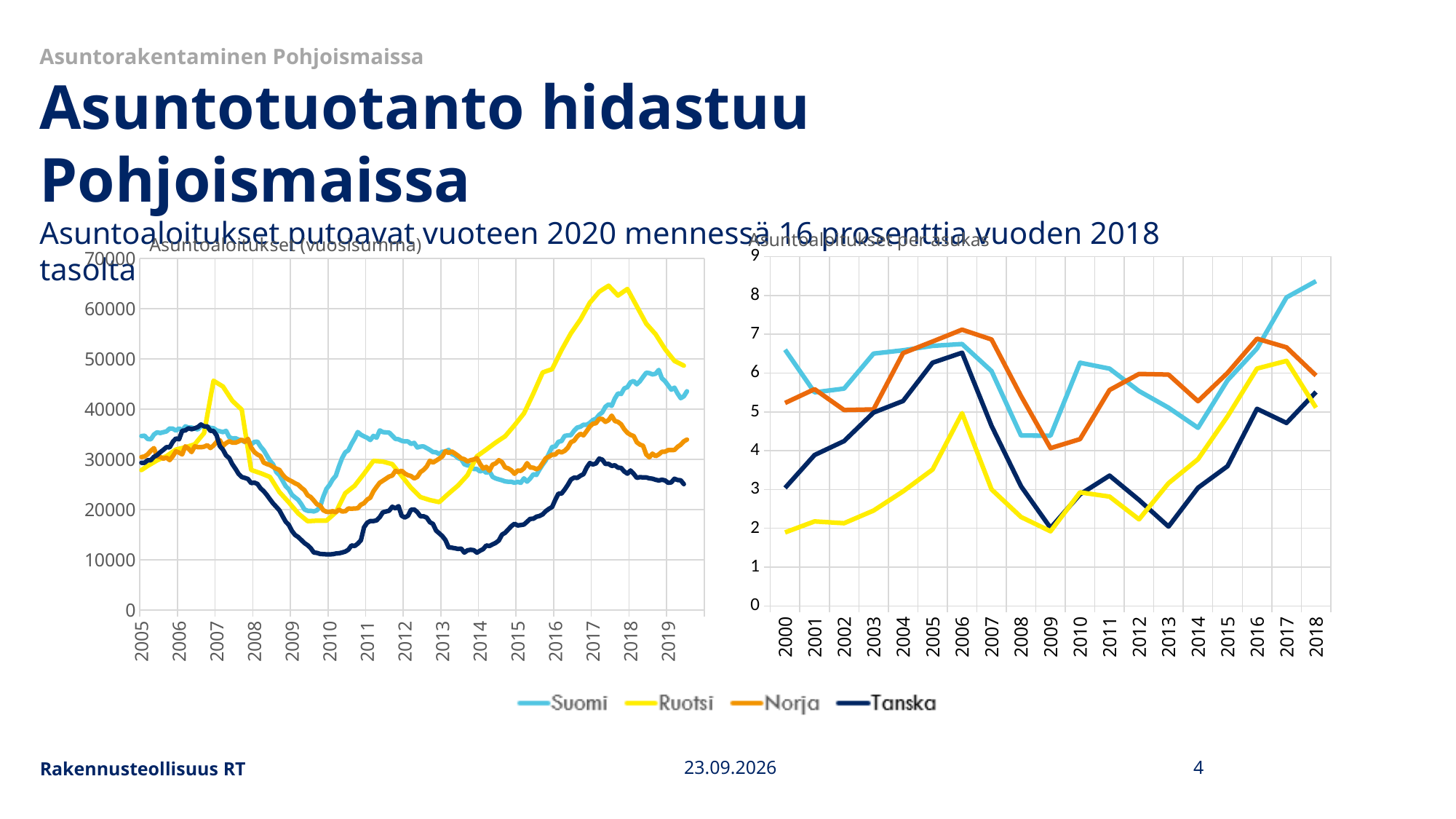
In the right chart 'Asuntoaloitukset per asukas', which is larger in 2009, Suomi or Tanska? Suomi In the left chart 'Asuntoaloitukset (vuosisumma)', which series has the highest value in 2017? Ruotsi In the right chart 'Asuntoaloitukset per asukas', which series has the lowest value in 2000? Ruotsi In the left chart 'Asuntoaloitukset (vuosisumma)', is the peak value for Ruotsi around 2017 greater or less than 60000? greater In the right chart 'Asuntoaloitukset per asukas', is the value for Suomi in 2018 greater or less than 8? greater What kind of chart is the left chart titled 'Asuntoaloitukset (vuosisumma)'? line chart In the right chart 'Asuntoaloitukset per asukas', which series has the highest value in 2018? Suomi In the right chart 'Asuntoaloitukset per asukas', does the Suomi line rise or fall from 2014 to 2018? rise In the left chart 'Asuntoaloitukset (vuosisumma)', is the value for Tanska around 2010 greater or less than 20000? less How many years are labelled on the x axis of the right chart 'Asuntoaloitukset per asukas'? 19 How many series does the shared legend list for the charts? 4